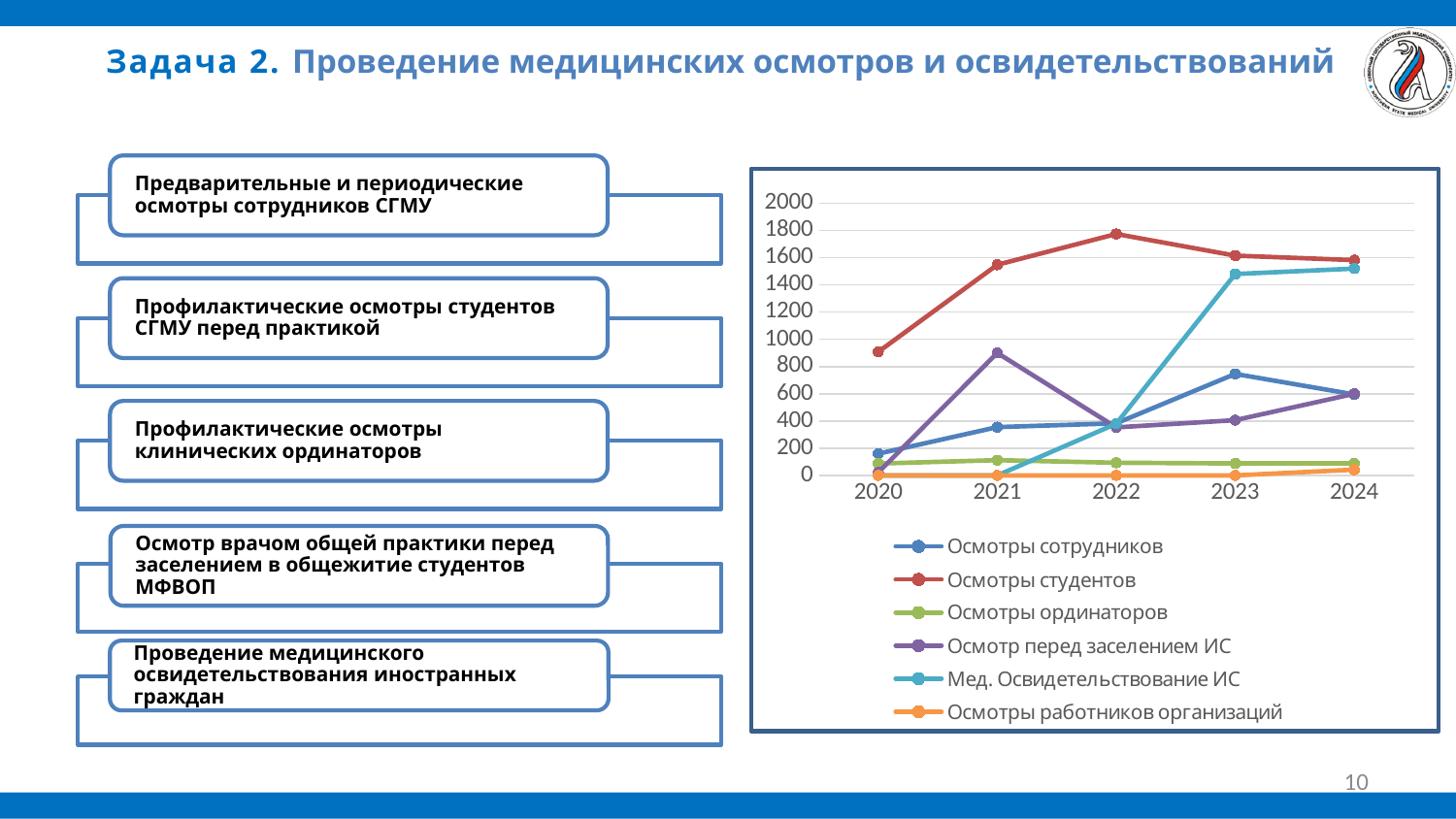
Is the value for 'Осмотры студентов' in 2022 greater or less than 1600? greater Which series has the highest value in 2021? Осмотры студентов Which series is shown in red in the chart? Осмотры студентов Does the series 'Мед. Освидетельствование ИС' rise or fall from 2022 to 2024? rise Is the value for 'Осмотры студентов' in 2020 greater or less than 1000? less What kind of chart is shown on the slide? line chart How many years are shown on the x axis of the chart? 5 In which year does the series 'Осмотры студентов' reach its highest value? 2022 Is the value for 'Осмотры сотрудников' in 2023 greater or less than 600? greater How many series does the chart legend list? 6 In 2021, which is larger: 'Осмотры студентов' or 'Осмотр перед заселением ИС'? Осмотры студентов